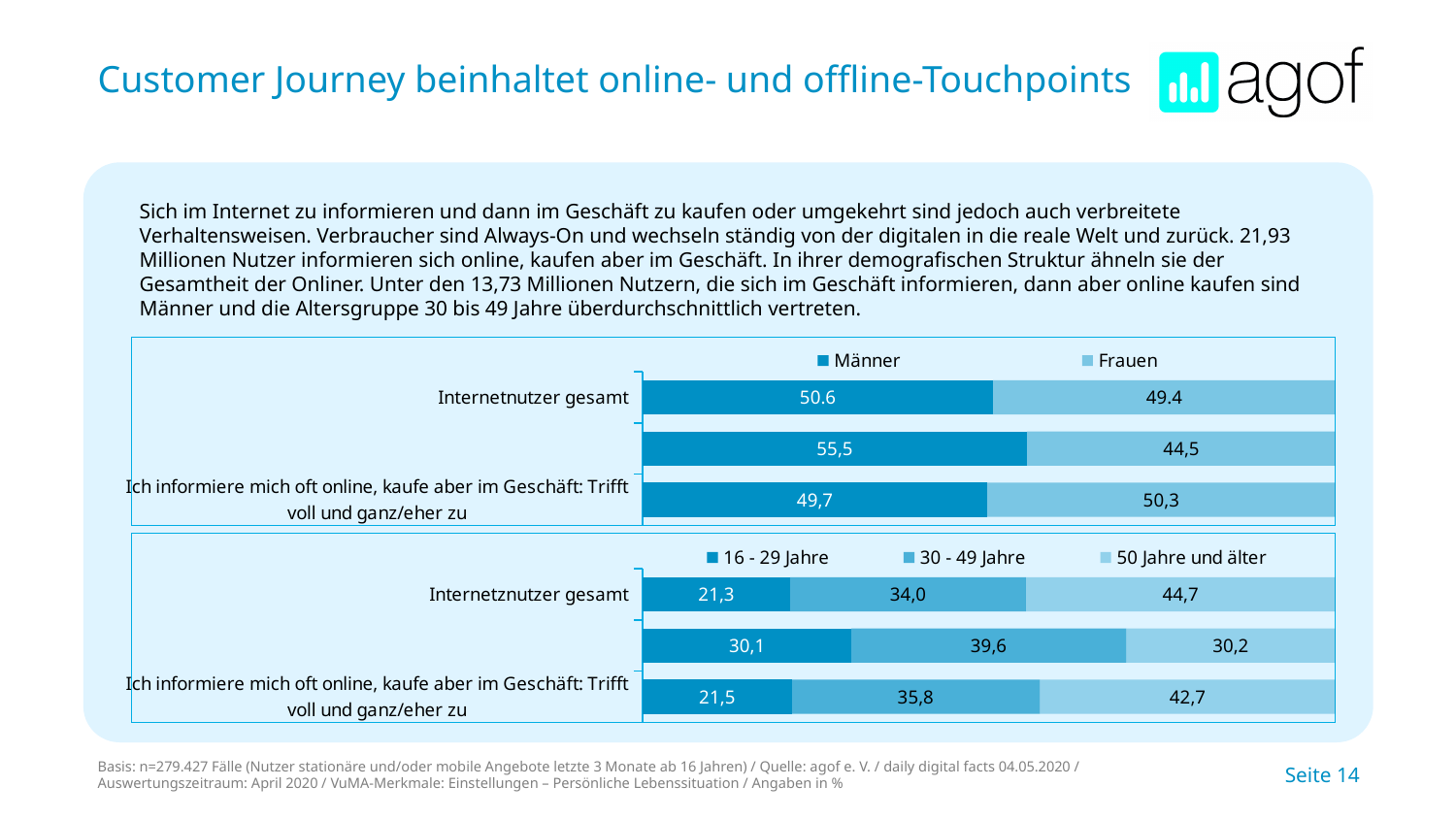
In the top chart (Männer/Frauen), what is the value for Männer in the 'Internetnutzer gesamt' bar? 50.6 How many series does the legend of the top chart (Männer/Frauen) list? 2 In the bottom chart (age groups), for 'Internetnutzer gesamt', which is larger: '30 - 49 Jahre' or '50 Jahre und älter'? 50 Jahre und älter In the top chart (Männer/Frauen), for the bar 'Ich informiere mich oft online, kaufe aber im Geschäft: Trifft voll und ganz/eher zu', which is larger: Männer or Frauen? Frauen How many series does the legend of the bottom chart (age groups) list? 3 In the bottom chart (age groups), what is the value for '16 - 29 Jahre' in the bar 'Ich informiere mich oft online, kaufe aber im Geschäft: Trifft voll und ganz/eher zu'? 21,5 In the bottom chart (age groups), for 'Internetnutzer gesamt', what is the difference between '50 Jahre und älter' and '16 - 29 Jahre'? 23,4 In the top chart (Männer/Frauen), for 'Internetnutzer gesamt', what is the difference between the Männer and Frauen values? 1.2 In the bottom chart (age groups), what is the value for '30 - 49 Jahre' in the bar 'Ich informiere mich oft online, kaufe aber im Geschäft: Trifft voll und ganz/eher zu'? 35,8 In the top chart (Männer/Frauen), what is the value for Frauen in the bar 'Ich informiere mich oft online, kaufe aber im Geschäft: Trifft voll und ganz/eher zu'? 50,3 In the bottom chart (age groups), what is the value for '50 Jahre und älter' in the 'Internetnutzer gesamt' bar? 44,7 What kind of chart is the top chart (Männer/Frauen)? Stacked bar chart